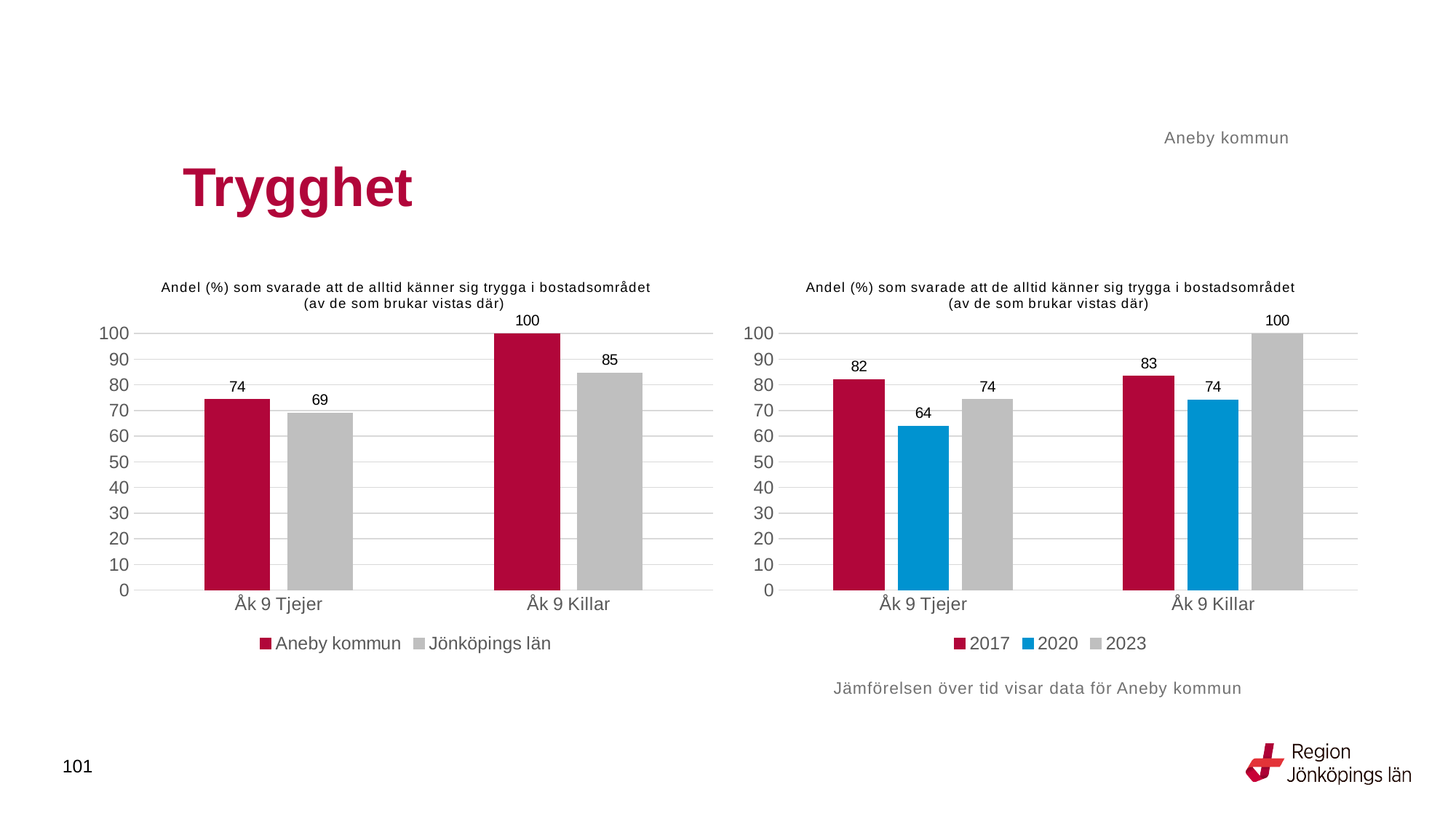
In the left chart, how many series does the legend list? 2 What kind of chart is the left chart? Bar chart In the left chart, what is the value for Aneby kommun for Åk 9 Tjejer? 74 In the left chart, what is the value for Jönköpings län for Åk 9 Killar? 85 In the right chart, which year has the lowest value for Åk 9 Tjejer? 2020 In the right chart, how many series does the legend list? 3 In the right chart, what is the value for 2020 for Åk 9 Tjejer? 64 In the left chart, what is the difference between Aneby kommun and Jönköpings län for Åk 9 Killar? 15 In the right chart, what is the difference between the 2023 and 2017 values for Åk 9 Killar? 17 In the right chart, what is the value for 2017 for Åk 9 Killar? 83 In the right chart, which year has the highest value for Åk 9 Killar? 2023 In the left chart, which is larger for Åk 9 Tjejer: Aneby kommun or Jönköpings län? Aneby kommun